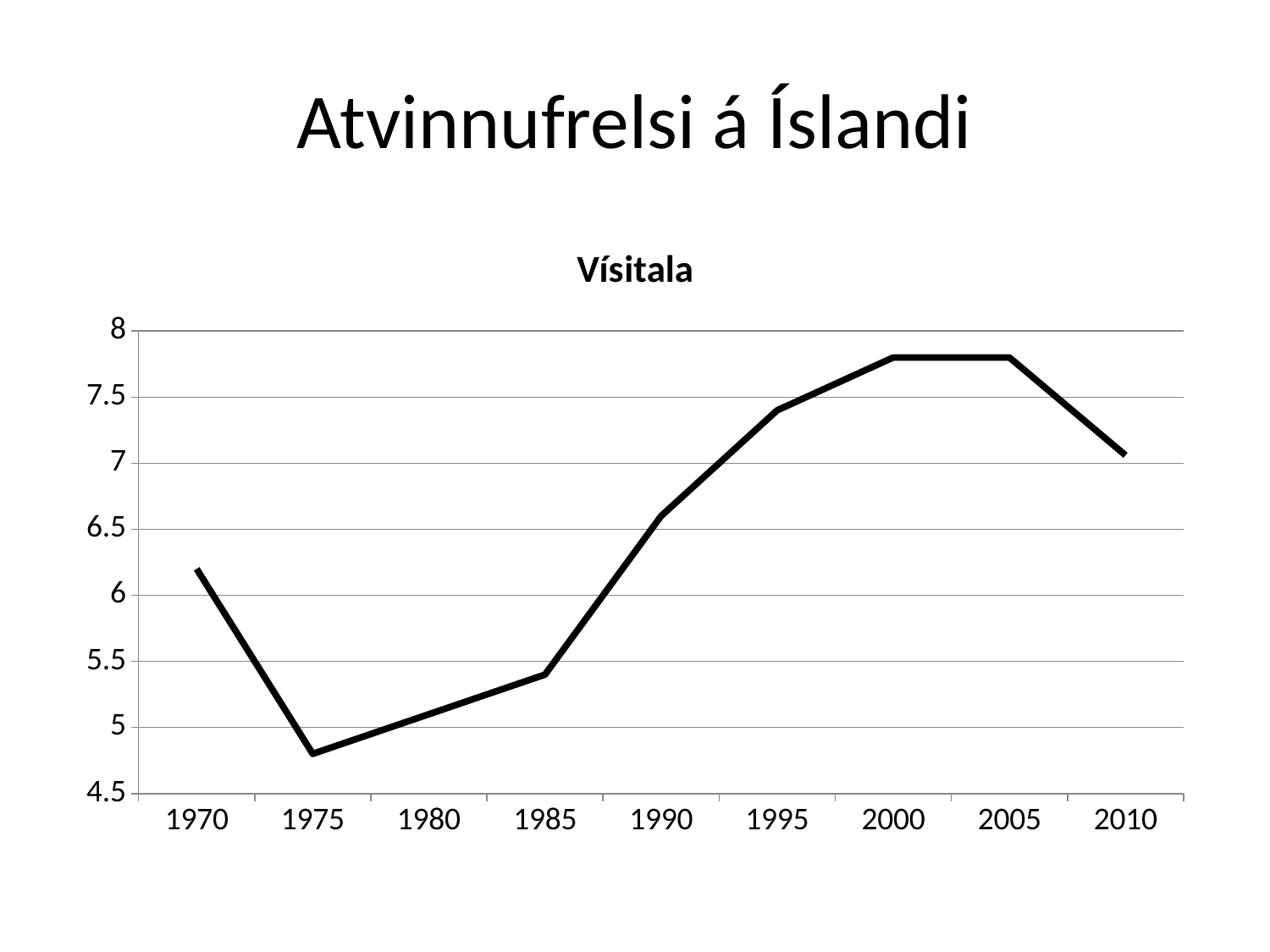
Do the values rise or fall from 1975 to 2000? rise Which is larger, the value for 1970 or the value for 1975? 1970 Is the value for 2000 greater or less than 7.5? greater Is the value for 1975 greater or less than 5? less What is the title of the chart? Vísitala Which year has the lowest value? 1975 Is the value for 1970 greater or less than 6? greater How many years are plotted on the x axis? 9 What kind of chart is shown on the slide? line chart Which is larger, the value for 2005 or the value for 2010? 2005